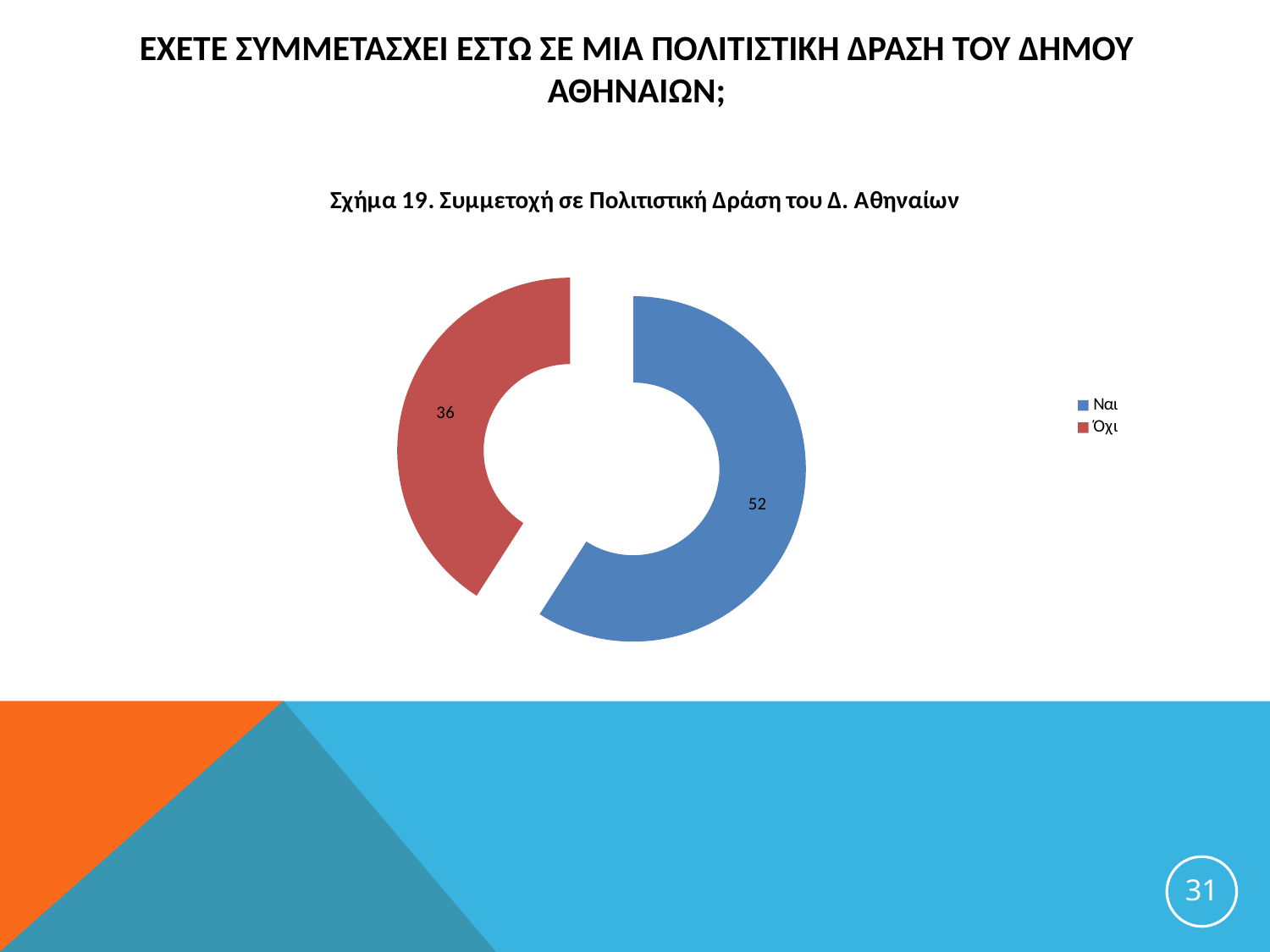
Which category has the smallest value in the chart? Όχι Which is larger, the value for Ναι or the value for Όχι? Ναι What kind of chart is shown on the slide? doughnut chart How many entries does the legend list? 2 What is the value for Όχι in the doughnut chart? 36 What is the difference between the values for Ναι and Όχι? 16 What is the total of the two values shown in the chart? 88 What colour is the Όχι slice in the chart? red How many categories does the chart show? 2 What is the value for Ναι in the doughnut chart? 52 Which category has the largest value in the chart? Ναι